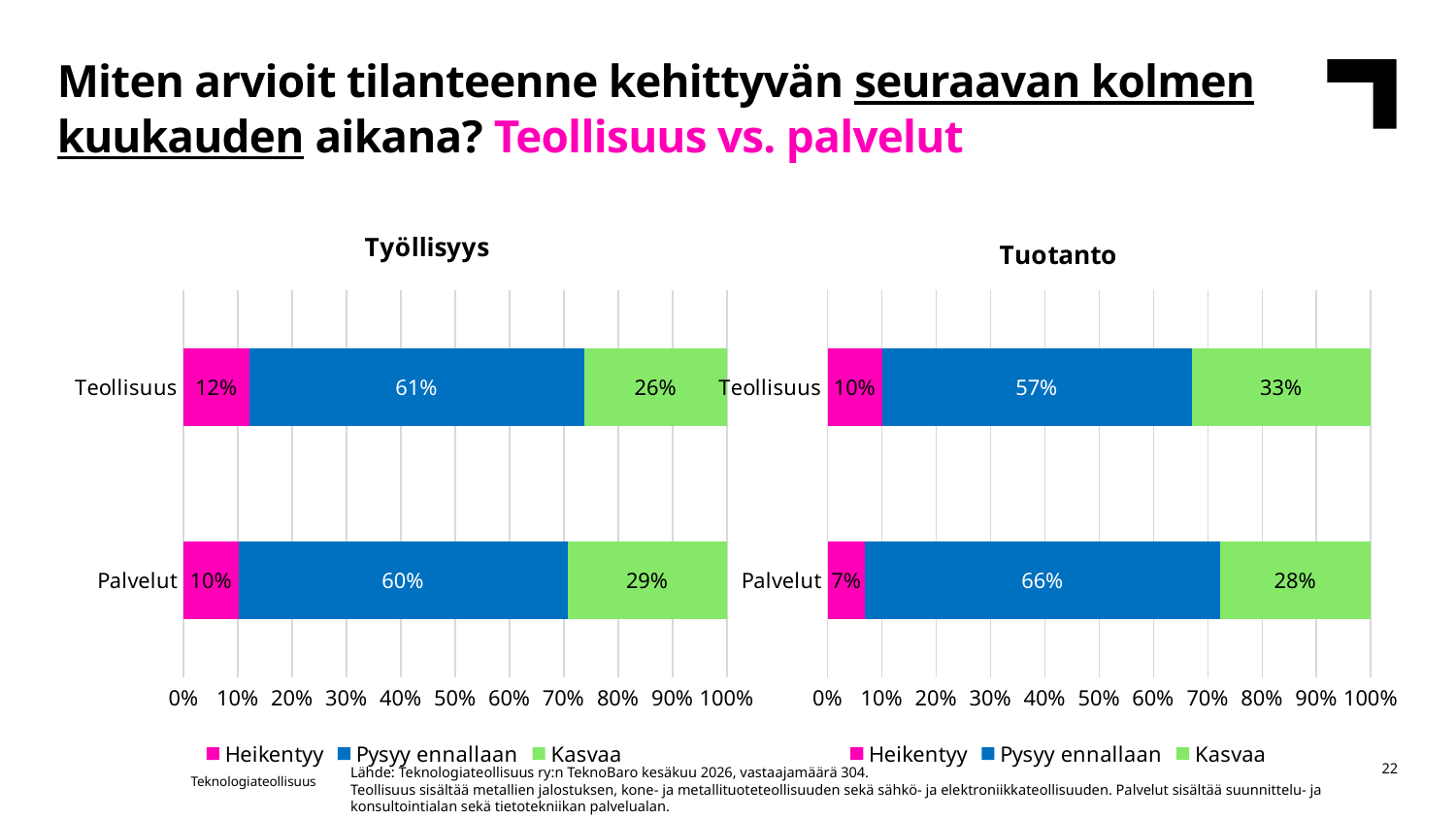
In the Työllisyys chart, what is the difference between the Kasvaa values for Palvelut and Teollisuus? 3% In the Tuotanto chart, what is the difference between the Pysyy ennallaan values for Palvelut and Teollisuus? 9% In the Työllisyys chart, which category has the higher Heikentyy value? Teollisuus How many series does the legend of the Tuotanto chart list? 3 In the Työllisyys chart, what is the Kasvaa value for Palvelut? 29% In the Työllisyys chart, what is the Pysyy ennallaan value for Teollisuus? 61% In the Tuotanto chart, which category has the higher Pysyy ennallaan value, Teollisuus or Palvelut? Palvelut In the Työllisyys chart, which colour represents the Kasvaa series? Green How many categories are shown in the Työllisyys chart? 2 In the Tuotanto chart, what is the Heikentyy value for Palvelut? 7% What kind of chart is the Tuotanto chart? Stacked bar chart In the Tuotanto chart, what is the Kasvaa value for Teollisuus? 33%